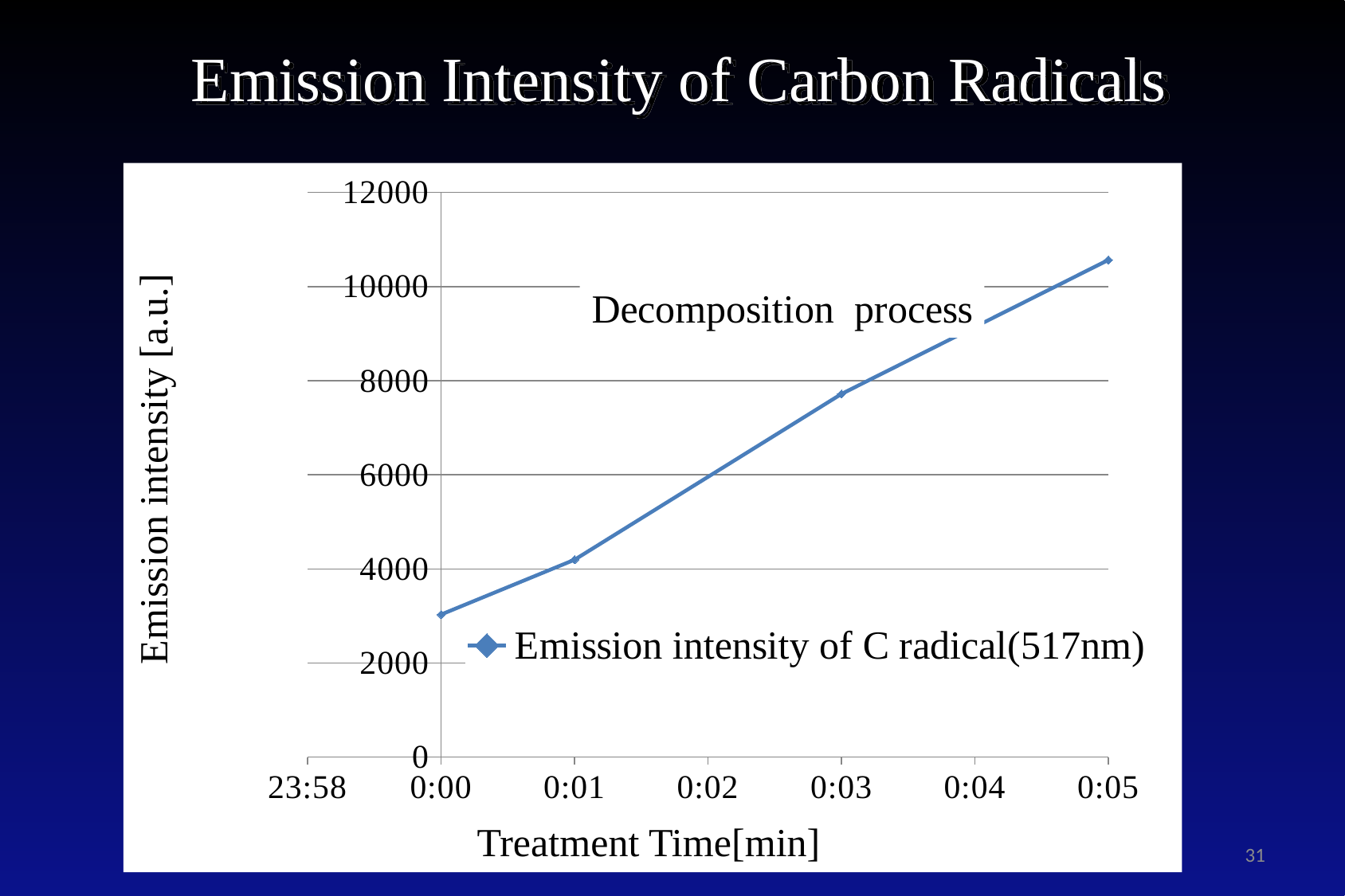
What is the legend entry for the plotted series? Emission intensity of C radical(517nm) Is the emission intensity at 0:05 greater or less than 10000? greater What text annotation is placed above the line in the chart? Decomposition process Which has the larger emission intensity, 0:01 or 0:03? 0:03 What kind of chart is shown on the slide? line chart At which treatment time is the emission intensity lowest? 0:00 How many series does the legend list? 1 How many data points are plotted on the line? 4 Is the emission intensity at 0:00 greater or less than 4000? less Does the emission intensity rise or fall as treatment time increases? rises Is the emission intensity at 0:03 greater or less than 6000? greater At which treatment time is the emission intensity highest? 0:05